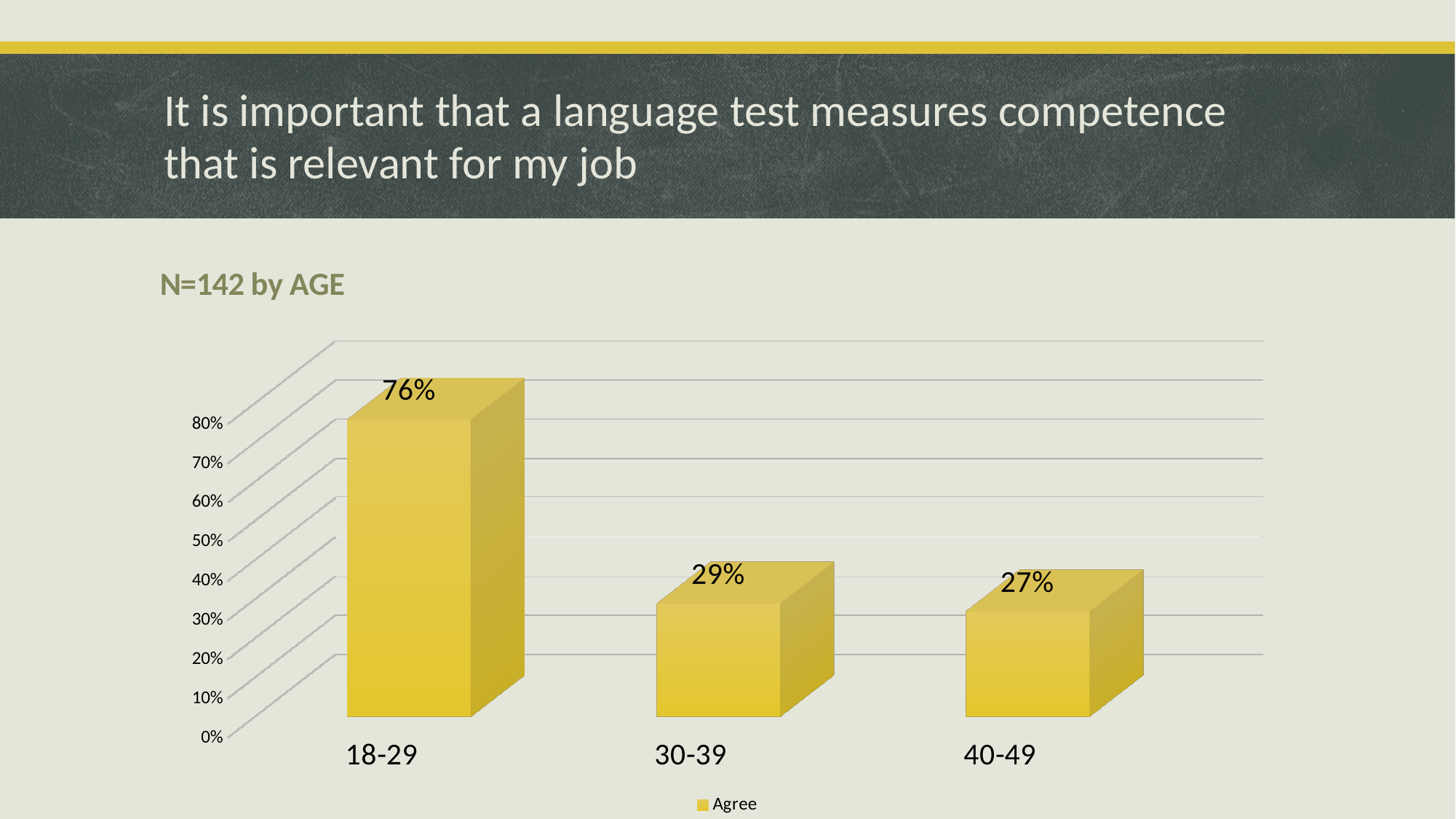
What kind of chart is shown on the slide? Bar chart What is the value for the 18-29 age group? 76% How many series does the legend list? 1 What is the value for the 30-39 age group? 29% What is the difference between the values for 18-29 and 30-39? 47% Which age group has the lowest value? 40-49 What is the value for the 40-49 age group? 27% What is the series name shown in the legend? Agree How many age groups are shown on the chart? 3 Which is larger, the value for 18-29 or the value for 40-49? 18-29 Which age group has the highest value? 18-29 What is the difference between the values for 30-39 and 40-49? 2%